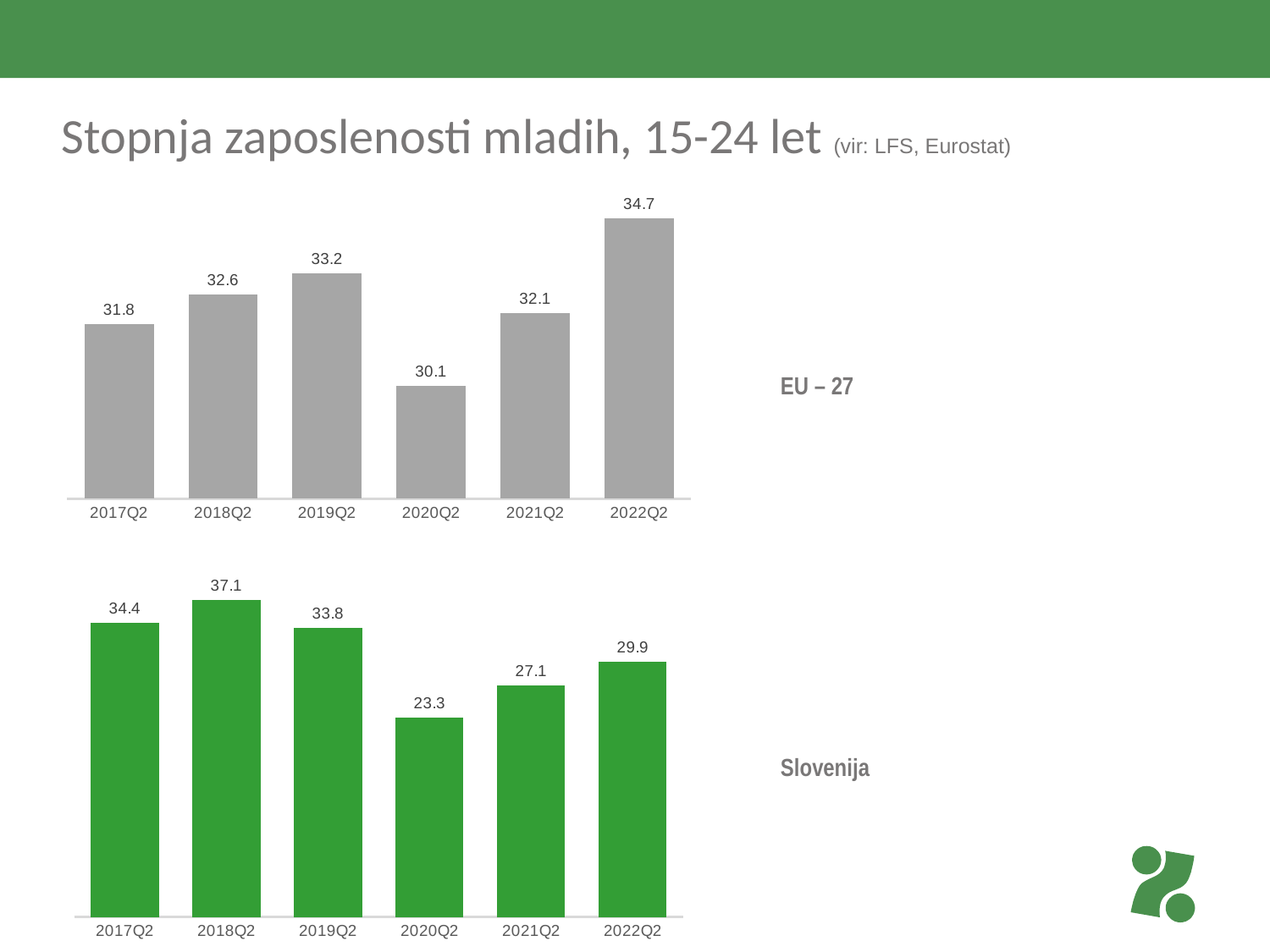
In the Slovenija chart (bottom), what is the value for 2018Q2? 37.1 How many periods are shown on the x axis of the Slovenija chart (bottom)? 6 In the Slovenija chart (bottom), which period has the lowest value? 2020Q2 In the Slovenija chart (bottom), which is larger: the value for 2017Q2 or the value for 2022Q2? 2017Q2 In the EU – 27 chart (top), what is the value for 2020Q2? 30.1 In the EU – 27 chart (top), which period has the highest value? 2022Q2 In the EU – 27 chart (top), which is larger: the value for 2019Q2 or the value for 2021Q2? 2019Q2 In the Slovenija chart (bottom), do the values rise or fall from 2018Q2 to 2020Q2? fall What colour are the bars in the Slovenija chart (bottom)? green In the Slovenija chart (bottom), what is the difference between the values for 2018Q2 and 2020Q2? 13.8 What kind of chart is the EU – 27 chart (top)? bar chart In the EU – 27 chart (top), what is the difference between the values for 2022Q2 and 2020Q2? 4.6